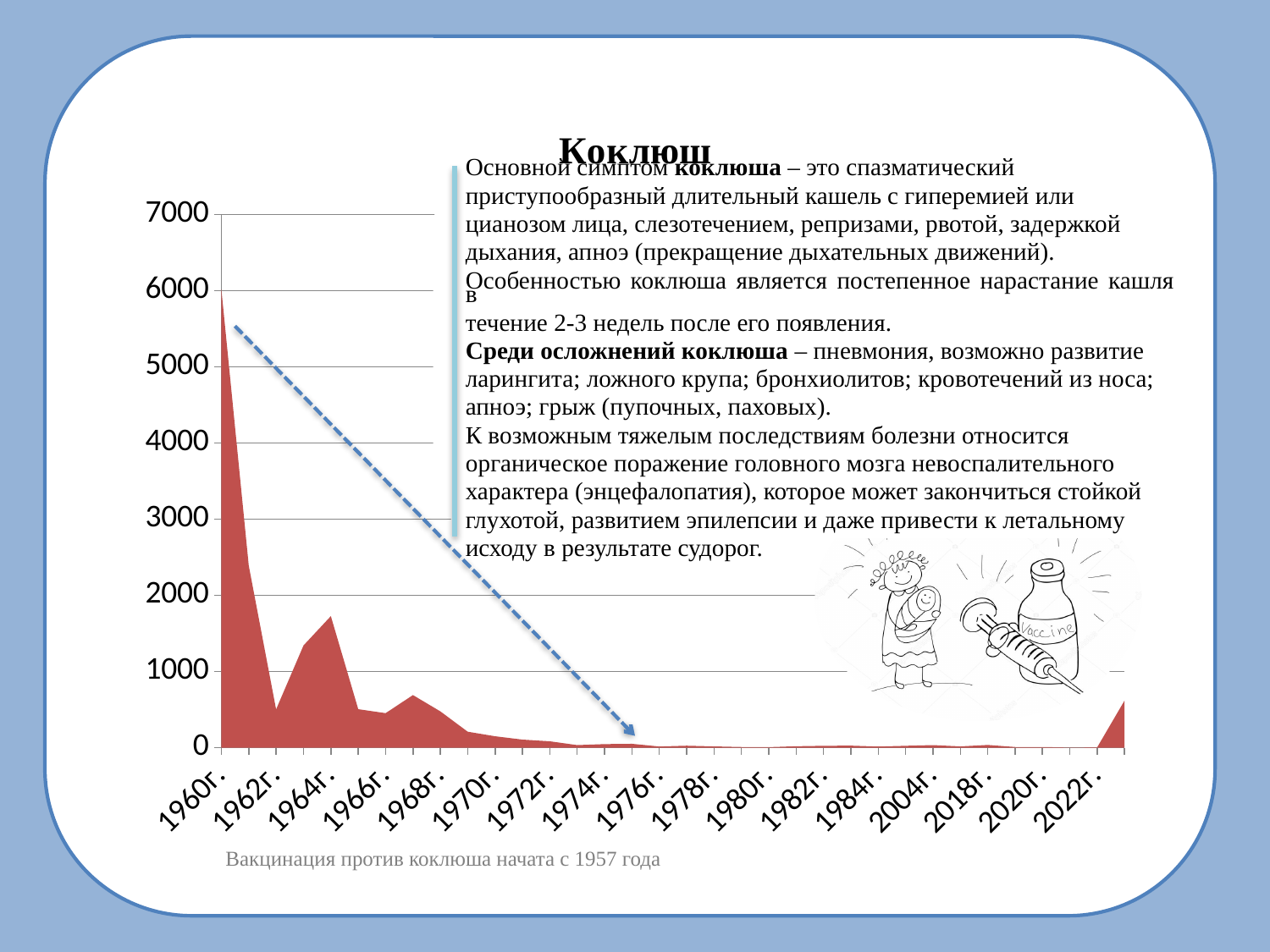
Which is larger, the value for 1964г. or the value for 1968г.? 1964г. Which is larger, the value for 1960г. or the value for 1964г.? 1960г. What is the title of the chart? Коклюш Is the value for 2022г. greater or less than 1000? less Do the values generally rise or fall from 1960г. to 1984г.? fall Is the value for 1968г. greater or less than 1000? less Is the value for 1964г. greater or less than 1000? greater What kind of chart is shown on the slide? area chart According to the note under the chart, in what year did vaccination against whooping cough begin? 1957 Which year has the highest value on the chart? 1960г.